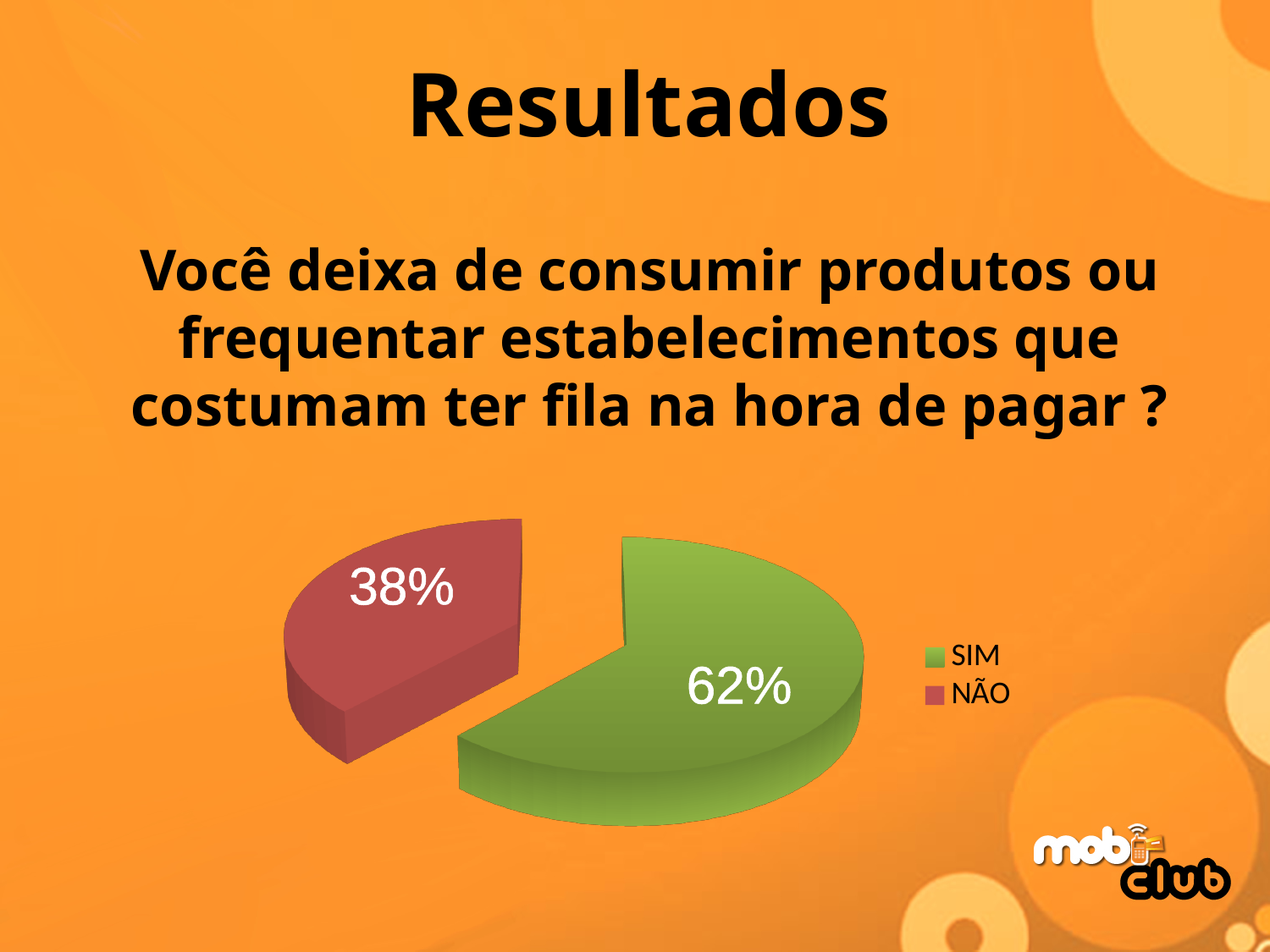
What colour is the SIM slice? green Which slice is the largest? SIM Which slice is the smallest? NÃO What is the difference in percentage points between SIM and NÃO? 24 What share of the pie does NÃO represent? 38% How many entries does the legend list? 2 How many slices does the pie chart have? 2 What colour is the NÃO slice? red What kind of chart is shown on the slide? pie chart Which is larger, SIM or NÃO? SIM What share of the pie does SIM represent? 62%